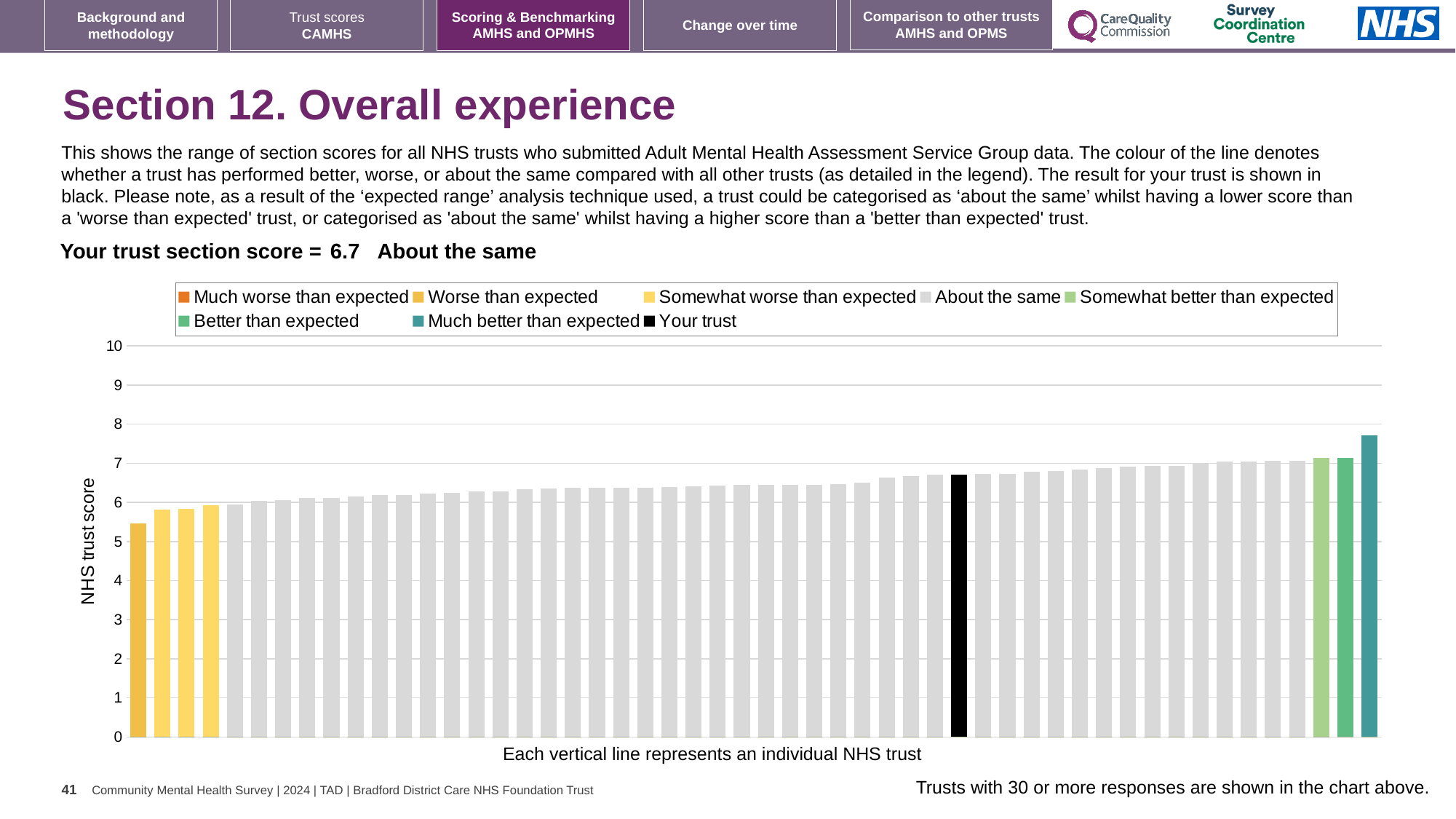
What is the section score for your trust shown on the slide? 6.7 How many bars in the chart are coloured in a shade of green (better than expected categories)? 3 How many entries does the chart legend list? 8 Is the value of the lowest bar in the chart greater or less than 6? less Which is larger: the value of your trust's black bar or the value of the rightmost teal bar? the rightmost teal bar What kind of chart is shown on the slide? bar chart Is the value of the highest bar in the chart greater or less than 7? greater Is the value for your trust (the black bar) greater or less than 6? greater Which category is your trust placed in for this section? About the same What is the label on the vertical axis of the chart? NHS trust score Do the bar values rise or fall from left to right across the chart? rise